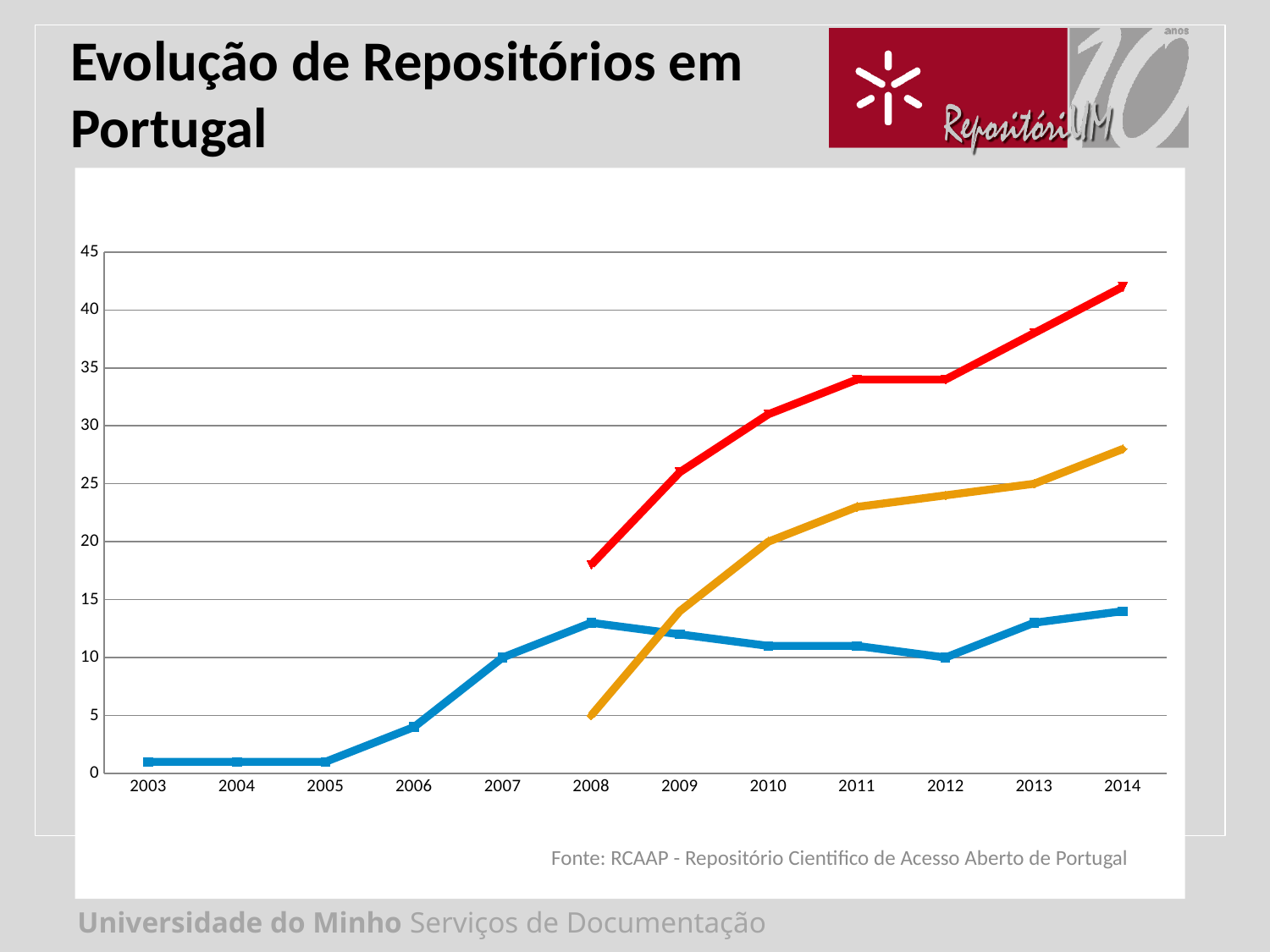
How many years are shown along the x axis of the chart? 12 What is the value of the orange line in 2008? 5 What is the first year shown on the x axis? 2003 Is the value of the red line in 2014 greater or less than 40? greater What is the value of the blue line in 2007? 10 What is the value of the orange line in 2010? 20 What is the last year shown on the x axis? 2014 Is the value of the red line in 2008 greater or less than 20? less Which line has the highest value in 2014: the red, orange or blue line? red Is the value of the blue line in 2014 greater or less than 15? less What kind of chart is shown on the slide? line chart Does the red line rise or fall from 2008 to 2014? rise